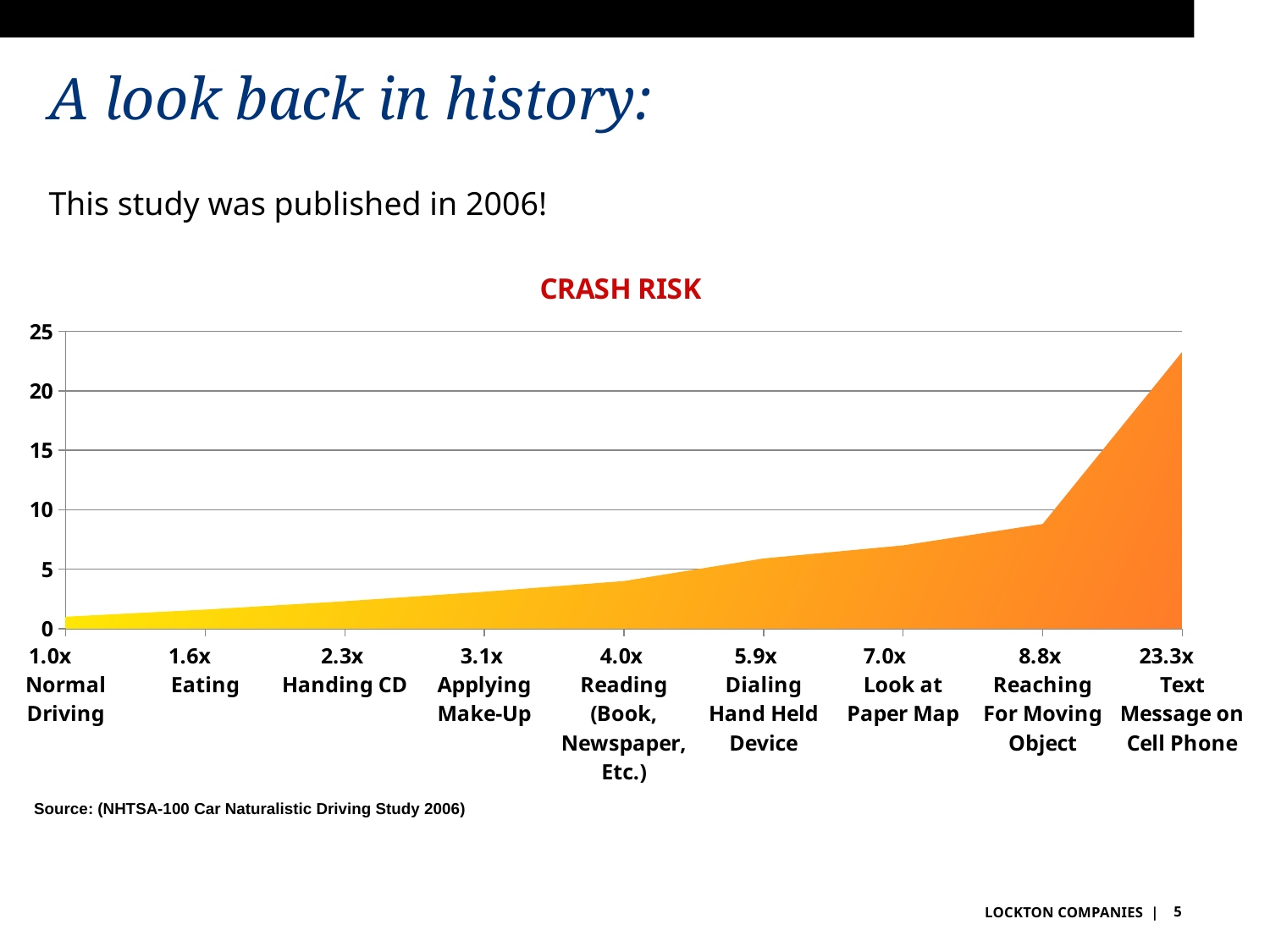
Which activity has the highest crash risk on the chart? Text Message on Cell Phone What is the crash risk value shown for Text Message on Cell Phone? 23.3x Which activity has the lowest crash risk on the chart? Normal Driving What is the difference between the crash risk for Text Message on Cell Phone and Reaching For Moving Object? 14.5x What kind of chart is used to show crash risk? area chart What is the crash risk value shown for Dialing Hand Held Device? 5.9x What is the crash risk value shown for Eating? 1.6x Do the crash risk values rise or fall from left to right along the x axis? rise How many activities are plotted on the chart? 9 Which has a higher crash risk, Look at Paper Map or Applying Make-Up? Look at Paper Map What is the crash risk value shown for Reaching For Moving Object? 8.8x Is the crash risk value for Text Message on Cell Phone greater or less than 20? greater